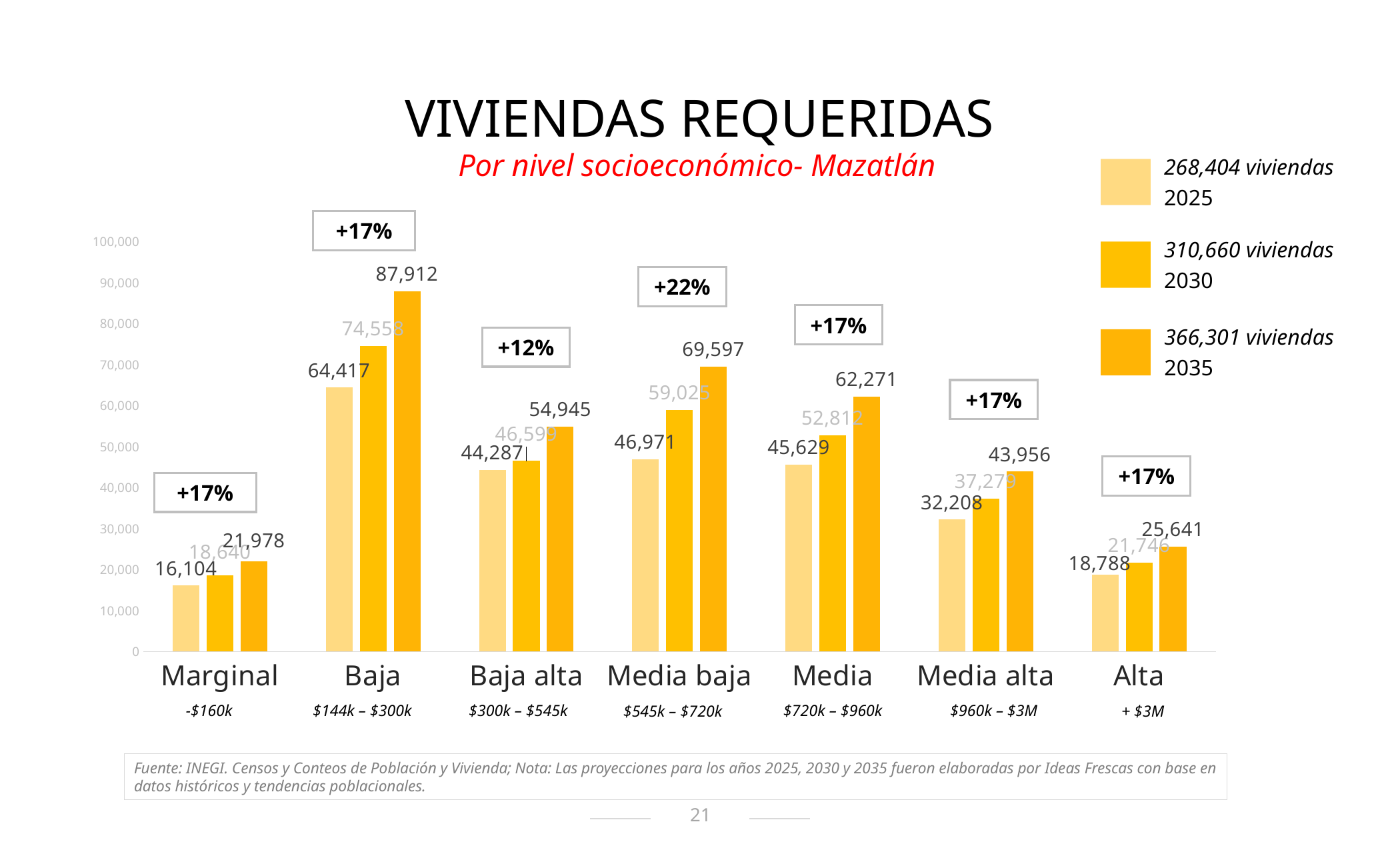
Is the 2035 value for Media baja greater or less than 60,000? greater What is the 2035 value for Baja? 87,912 Which category has the highest 2035 value? Baja Which is larger, the 2030 value for Media or the 2030 value for Baja alta? Media What is the 2030 value for Media alta? 37,279 What kind of chart is shown on the slide? bar chart What is the difference between the 2035 and 2025 values for Baja? 23,495 What is the 2025 value for Media baja? 46,971 How many socioeconomic categories are shown on the x axis? 7 Which category has the lowest 2025 value? Marginal How many series does the legend list? 3 What percentage increase is shown in the box above the Media baja group? +22%